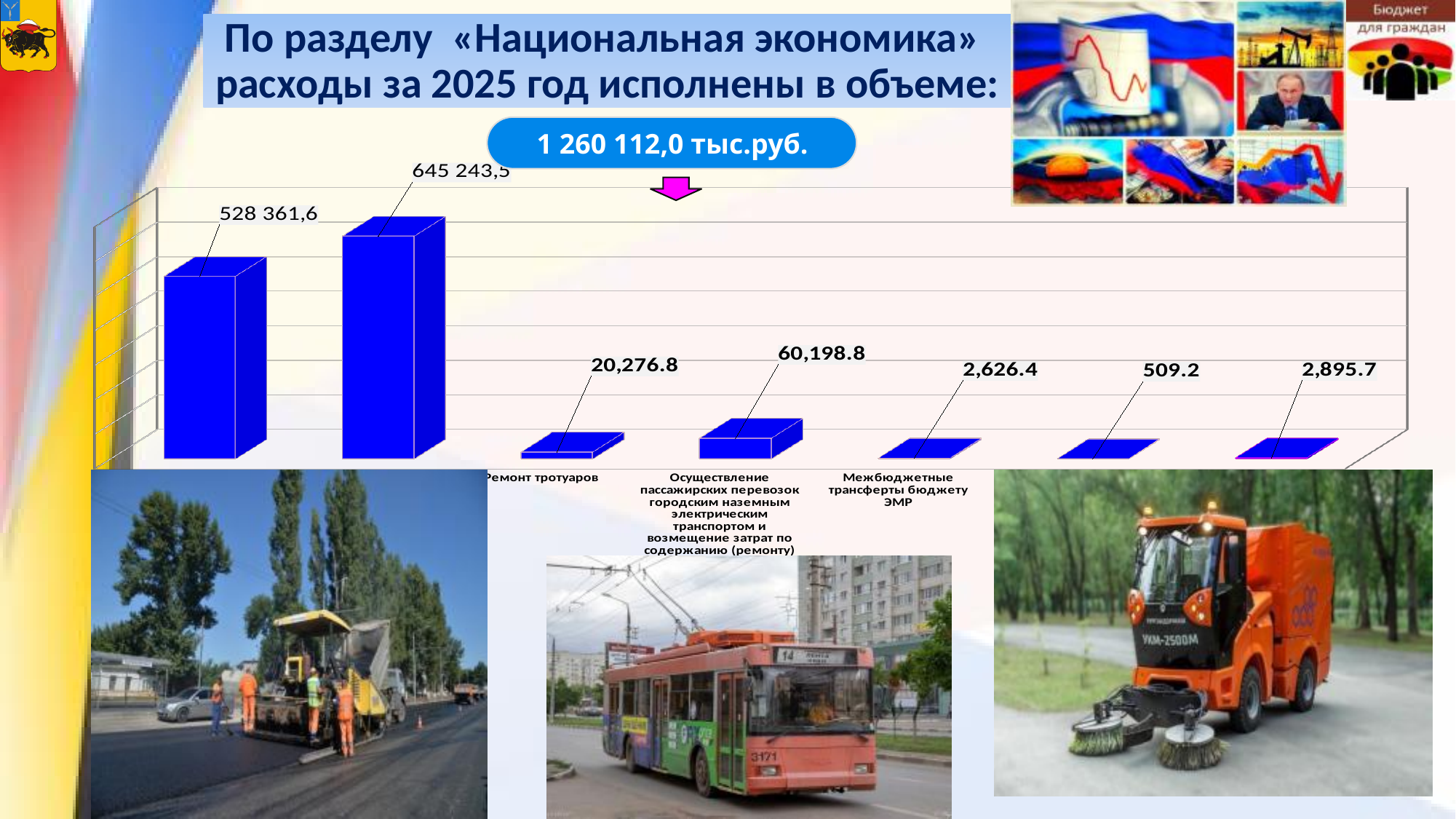
What is the value for Осуществление пассажирских перевозок городским наземным электрическим транспортом и возмещение затрат по содержанию (ремонту)? 60,198.8 What is the difference between the value for Осуществление пассажирских перевозок городским наземным электрическим транспортом and the value for Ремонт тротуаров? 39,922.0 What is the difference between the two tallest bars, labelled 645 243,5 and 528 361,6? 116 881,9 Which is larger: the value for Ремонт тротуаров or the value for Межбюджетные трансферты бюджету ЭМР? Ремонт тротуаров How many bars are plotted on the chart? 7 What is the value for Ремонт тротуаров? 20,276.8 What is the value for Межбюджетные трансферты бюджету ЭМР? 2,626.4 What colour are the bars on the chart? blue What is the highest value labelled on the chart? 645 243,5 What total amount is shown in the callout above the chart? 1 260 112,0 тыс.руб. What kind of chart is shown on the slide? bar chart What is the lowest value labelled on the chart? 509.2